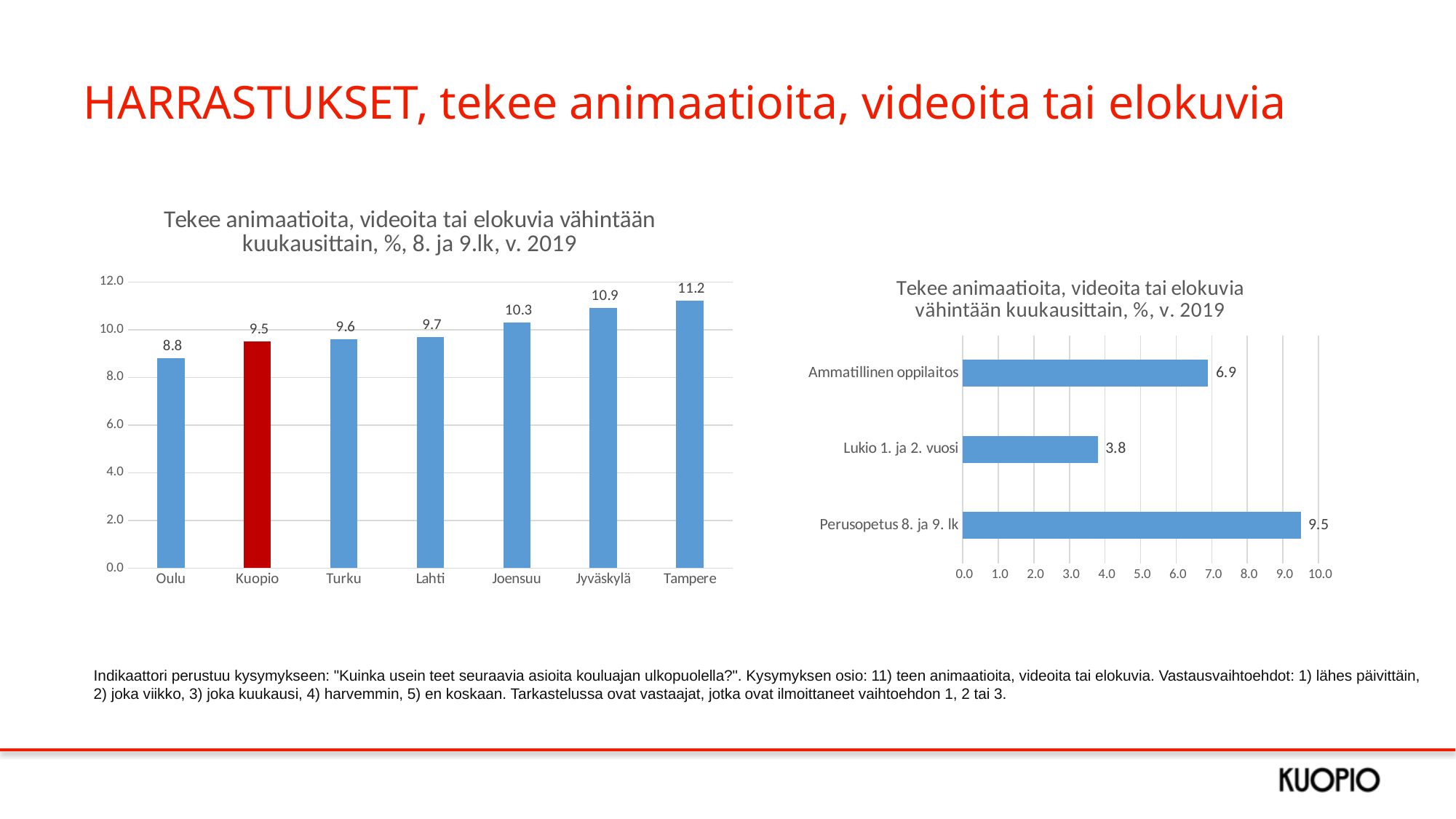
In the right chart (v. 2019), which category has the highest value? Perusopetus 8. ja 9. lk In the left chart (8. ja 9.lk, v. 2019), which has a larger value, Joensuu or Lahti? Joensuu In the left chart (8. ja 9.lk, v. 2019), which city has the lowest value? Oulu In the left chart (8. ja 9.lk, v. 2019), which city has the highest value? Tampere In the left chart (8. ja 9.lk, v. 2019), what is the difference between the values for Tampere and Oulu? 2.4 In the left chart (8. ja 9.lk, v. 2019), how many cities are shown? 7 In the right chart (v. 2019), what is the value for Lukio 1. ja 2. vuosi? 3.8 In the left chart (8. ja 9.lk, v. 2019), do the values rise or fall from Oulu to Tampere? rise In the left chart (8. ja 9.lk, v. 2019), what is the value for Kuopio? 9.5 In the right chart (v. 2019), what is the difference between Ammatillinen oppilaitos and Lukio 1. ja 2. vuosi? 3.1 What kind of chart is the right chart (v. 2019)? bar chart In the left chart (8. ja 9.lk, v. 2019), which bar is coloured red? Kuopio